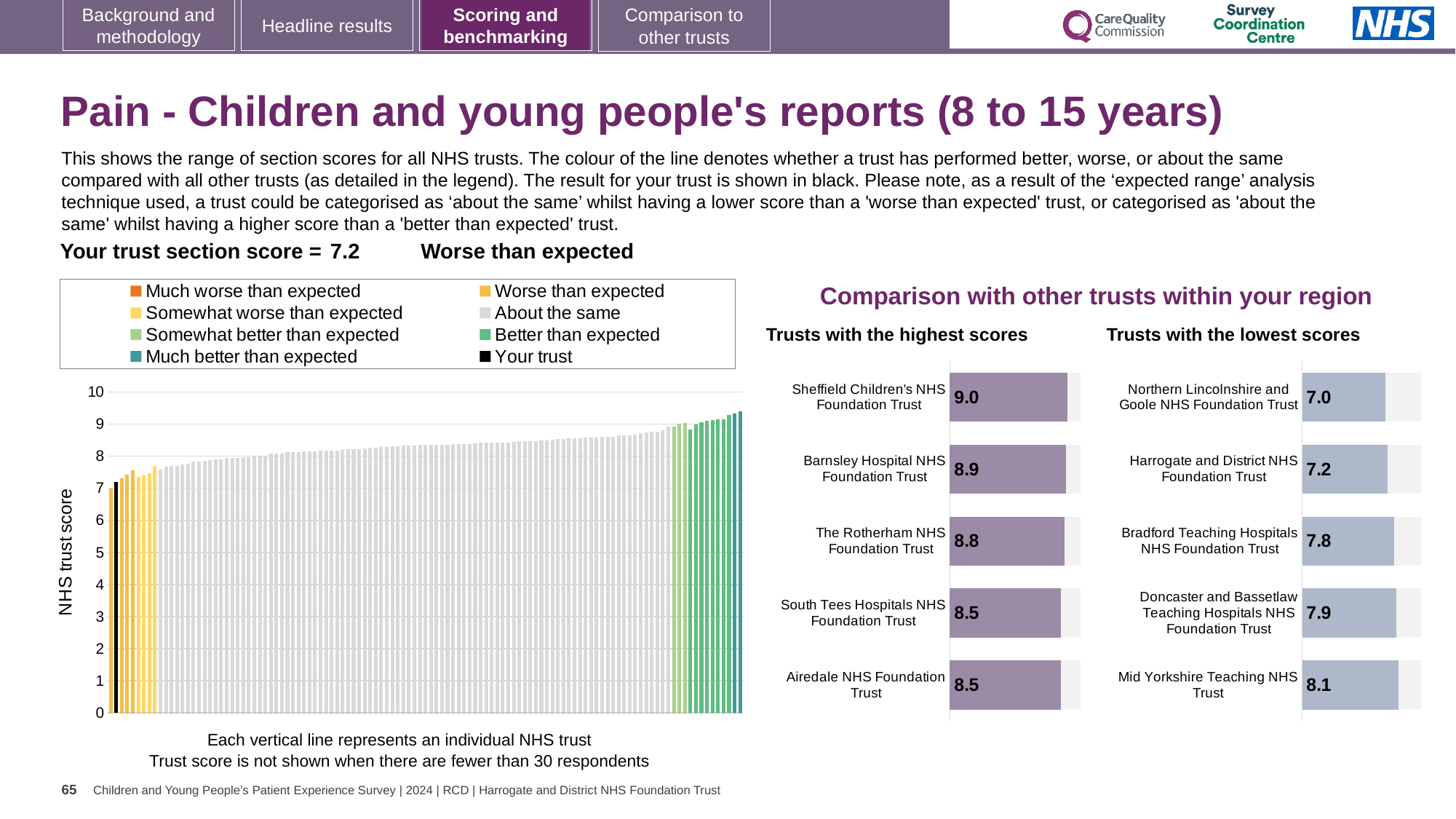
In the 'Trusts with the lowest scores' chart, which has the larger score: Bradford Teaching Hospitals NHS Foundation Trust or Doncaster and Bassetlaw Teaching Hospitals NHS Foundation Trust? Doncaster and Bassetlaw Teaching Hospitals NHS Foundation Trust In the 'Trusts with the lowest scores' chart, what is the difference between the scores of Mid Yorkshire Teaching NHS Trust and Northern Lincolnshire and Goole NHS Foundation Trust? 1.1 In the 'Trusts with the highest scores' chart, what is the score for Sheffield Children's NHS Foundation Trust? 9.0 In the large chart on the left, do the trust scores rise or fall from left to right? rise How many trusts are shown in the 'Trusts with the highest scores' chart? 5 In the 'Trusts with the lowest scores' chart, which trust has the lowest score? Northern Lincolnshire and Goole NHS Foundation Trust In the 'Trusts with the highest scores' chart, which trust has the highest score? Sheffield Children's NHS Foundation Trust In the 'Trusts with the lowest scores' chart, what is the score for Harrogate and District NHS Foundation Trust? 7.2 In the 'Trusts with the highest scores' chart, what is the difference between the scores of Sheffield Children's NHS Foundation Trust and The Rotherham NHS Foundation Trust? 0.2 What kind of chart is the large chart on the left with the y axis labelled 'NHS trust score'? bar chart In the large chart on the left, what colour represents 'Your trust' according to the legend? black How many entries does the legend above the large chart on the left list? 8